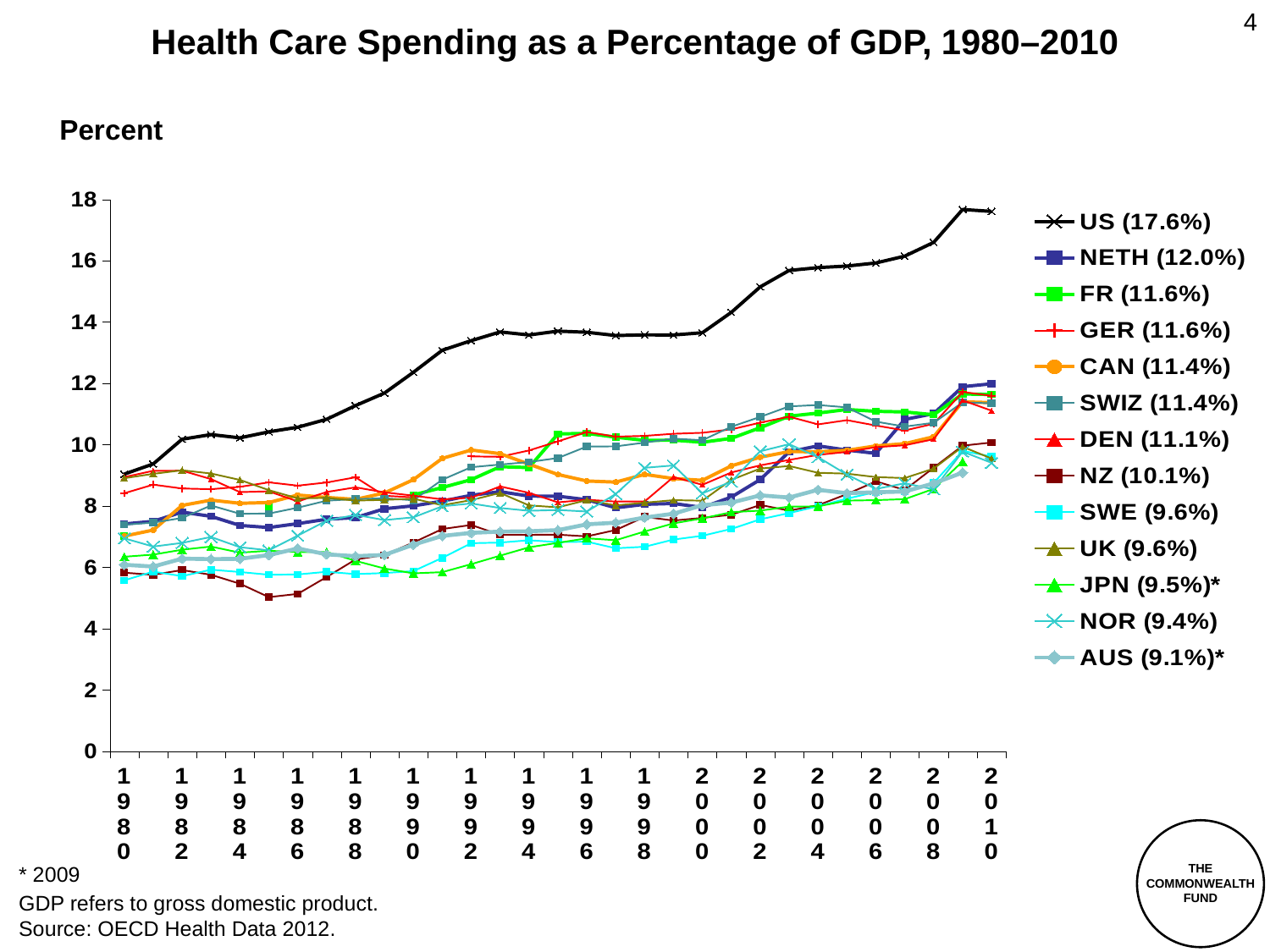
What is the health care spending as a percentage of GDP shown for NETH in the legend? 12.0% Which is larger according to the legend, the value for DEN or the value for NZ? DEN What kind of chart is shown on the slide? Line chart Which country has the lowest health care spending as a percentage of GDP according to the legend? AUS (9.1%) How many series does the legend list? 13 Does the US line rise or fall from 1980 to 2010? Rises Is the value for the US in 2010 greater or less than 16? greater What is the difference between the US value and the NETH value shown in the legend? 5.6 percentage points What is the health care spending as a percentage of GDP shown for CAN in the legend? 11.4% Which country has the highest health care spending as a percentage of GDP according to the legend? US (17.6%) Is the value for the US in 1980 greater or less than 10? less What is the title of the chart? Health Care Spending as a Percentage of GDP, 1980–2010